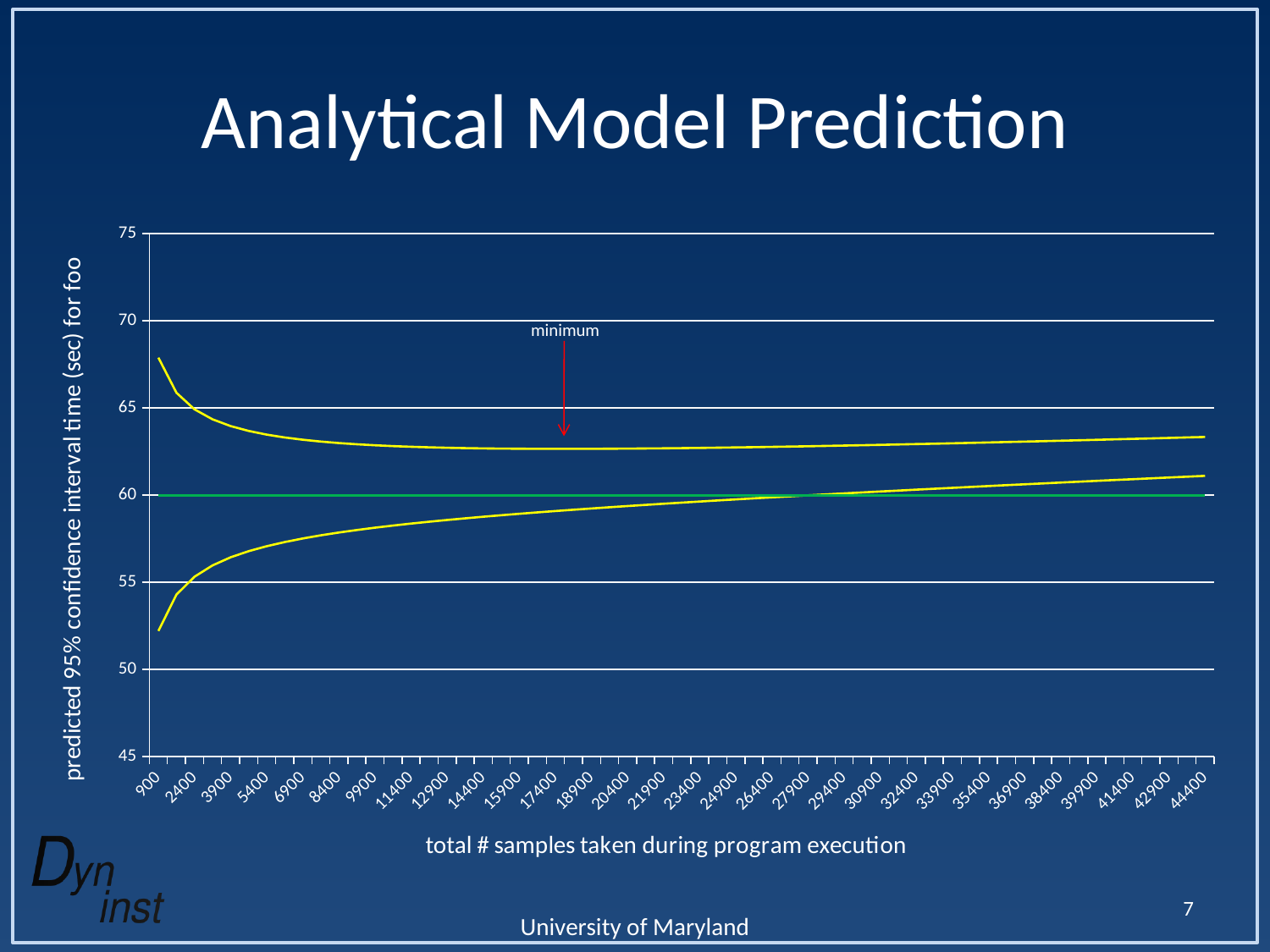
Is the value of the upper yellow line at 44400 samples greater or less than 65? less At 44400 samples, which is higher: the lower yellow line or the green line? the lower yellow line What is the title of the x axis of the chart? total # samples taken during program execution What label does the red arrow annotation on the chart point to? minimum How many lines are plotted on the chart? 3 Is the value of the upper yellow line at 17400 samples greater or less than 65? less Is the value of the upper yellow line at 900 samples greater or less than 65? greater What value does the flat green line sit at on the y axis? 60 What kind of chart is shown on the slide? line chart Does the lower yellow line rise or fall as the number of samples increases along the x axis? rise